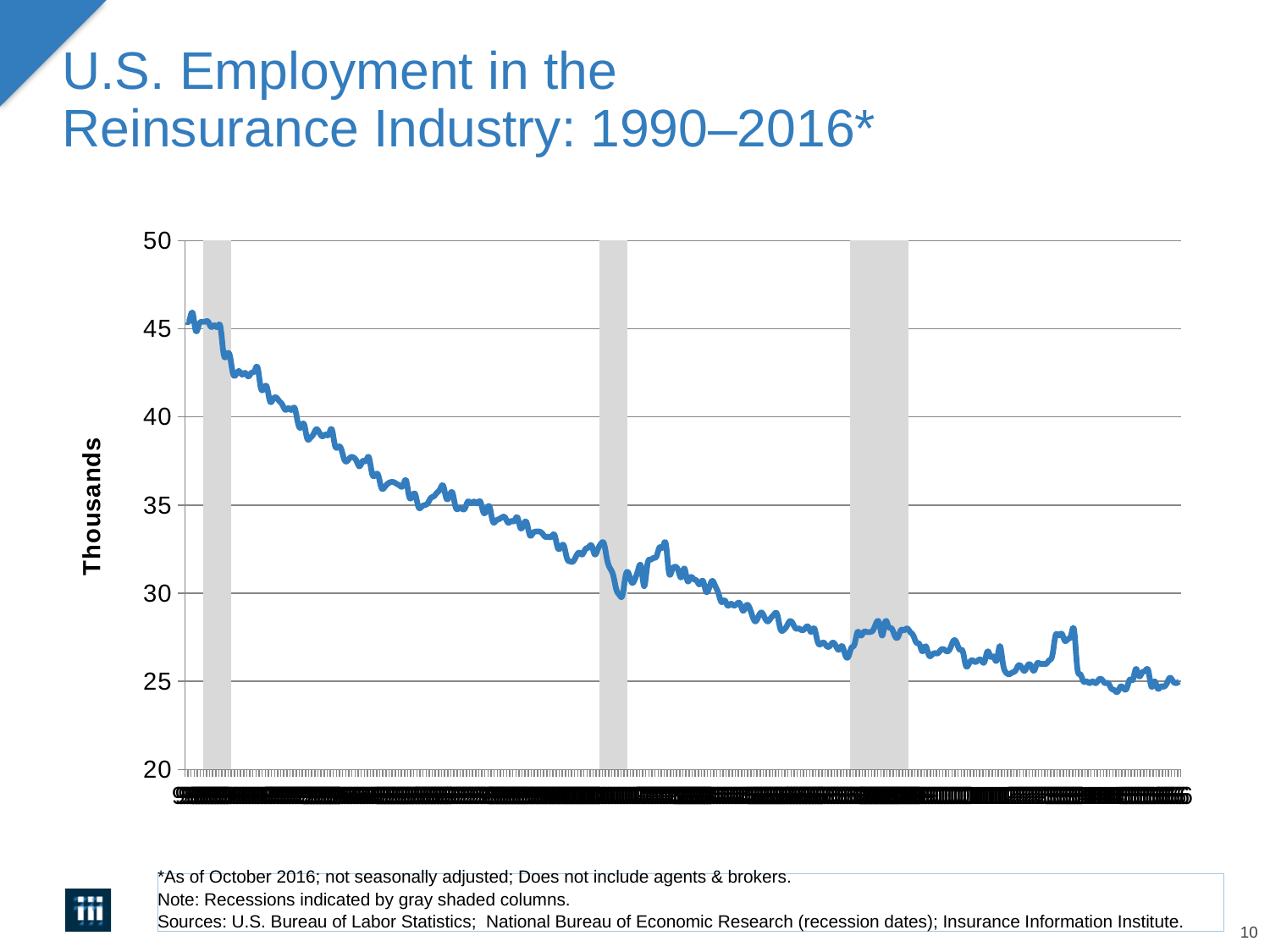
What is the label on the vertical axis of the chart? Thousands Is the value at the end of the series greater or less than 30? less Is the lowest point on the line greater or less than 20? greater Is the value at the end of the series greater or less than 20? greater What kind of chart is shown on the slide? line chart How many gray shaded recession columns appear on the chart? 3 Does the employment line generally rise or fall from left to right across the chart? fall Which is larger, the value at the start of the series or the value at the end of the series? the start of the series Where along the x axis does the line reach its highest value? at the beginning of the series